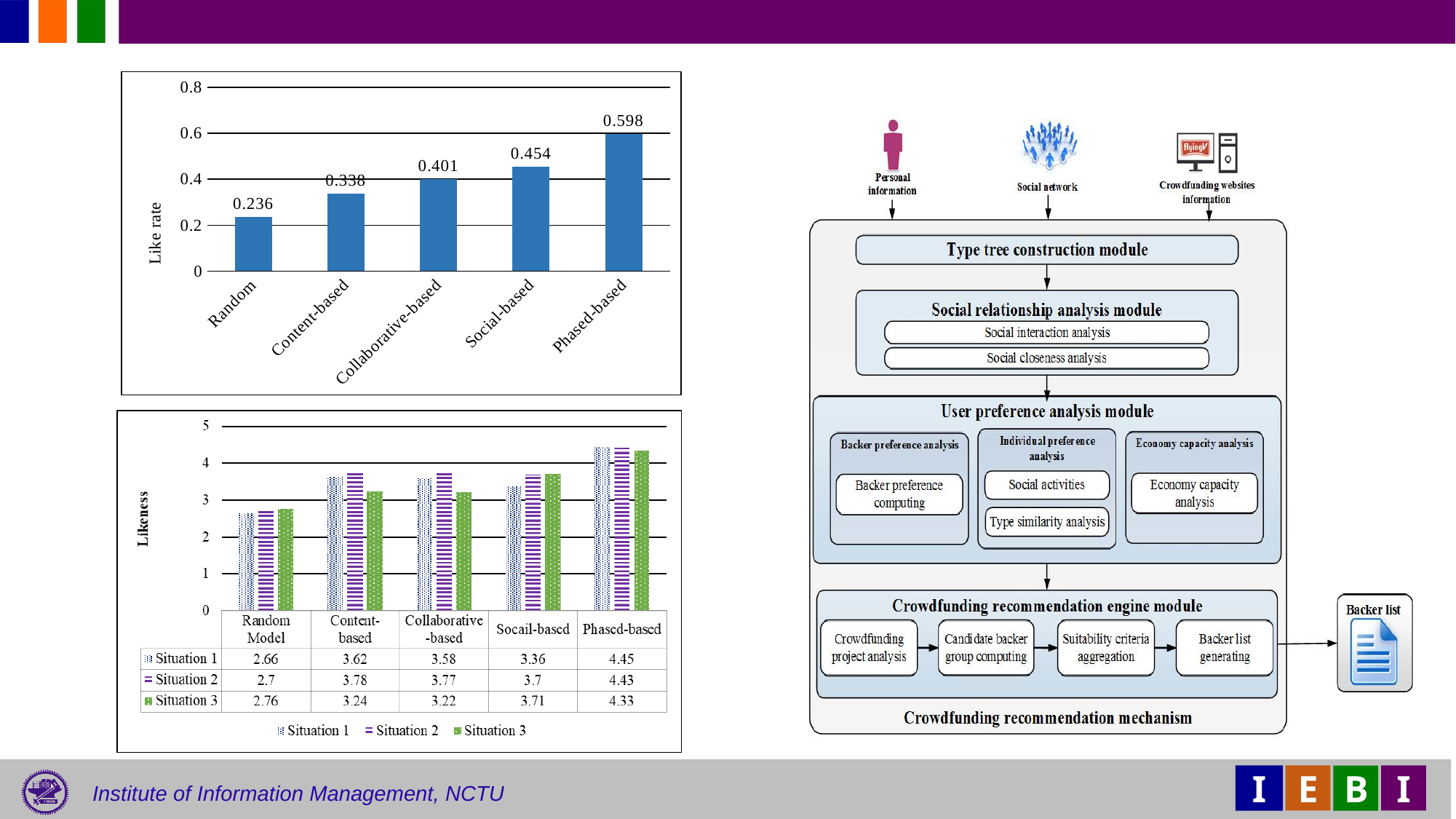
In the bottom-left chart, which is larger for Collaborative-based: Situation 1 or Situation 3? Situation 1 What kind of chart is the top-left chart? bar chart In the top-left chart, which category has the highest like rate? Phased-based In the top-left chart, do the like rate values rise or fall from left to right along the x axis? rise In the top-left chart, how many categories are shown on the x axis? 5 In the top-left chart, what is the like rate for Phased-based? 0.598 In the bottom-left chart, how many series does the legend list? 3 In the top-left chart, what is the like rate for Random? 0.236 In the bottom-left chart, what is the Likeness value for Situation 2 for Content-based? 3.78 In the bottom-left chart, what is the Likeness value for Situation 3 for Phased-based? 4.33 In the top-left chart, what is the difference in like rate between Social-based and Collaborative-based? 0.053 In the top-left chart, which category has the lowest like rate? Random